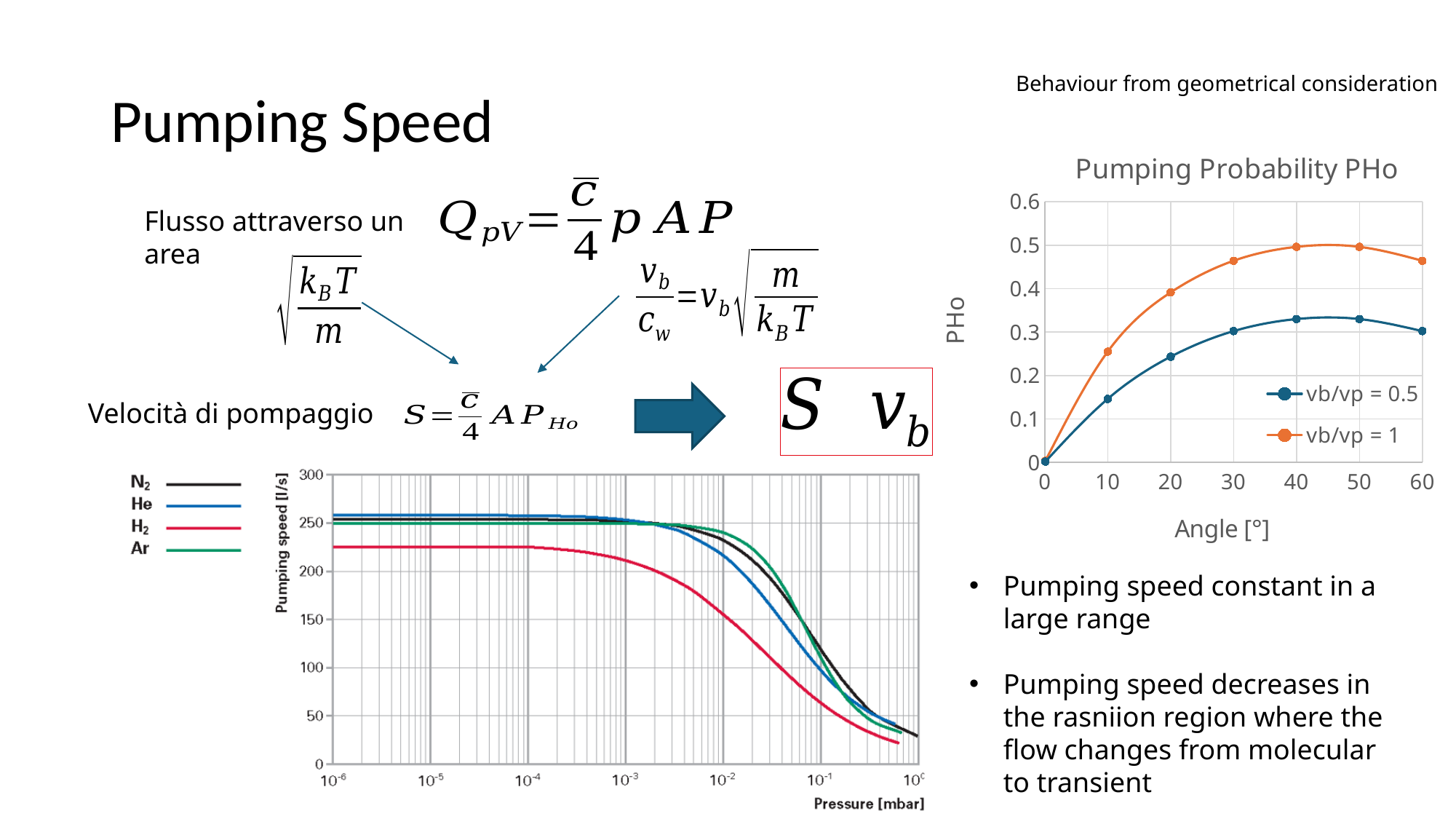
In the Pumping Probability PHo chart, which series has the higher value at 30°, vb/vp = 0.5 or vb/vp = 1? vb/vp = 1 In the bottom-left pumping speed vs pressure chart, how many gases does the legend list? 4 In the Pumping Probability PHo chart, is the value for vb/vp = 1 at 20° greater or less than 0.3? greater What kind of chart is the Pumping Probability PHo chart? line chart In the bottom-left pumping speed vs pressure chart, is the pumping speed for H2 at 10^-1 mbar greater or less than 100 l/s? less In the bottom-left pumping speed vs pressure chart, which gas has the larger pumping speed at 10^-2 mbar, H2 or Ar? Ar In the Pumping Probability PHo chart, how many series does the legend list? 2 What is the x-axis label of the Pumping Probability PHo chart? Angle [°] In the Pumping Probability PHo chart, is the value for vb/vp = 0.5 at 10° greater or less than 0.1? greater In the Pumping Probability PHo chart, how many data points are plotted for the vb/vp = 1 series? 7 In the Pumping Probability PHo chart, does the vb/vp = 1 series rise or fall between 0° and 30°? rise In the bottom-left pumping speed vs pressure chart, which gas has the lowest pumping speed at 10^-6 mbar? H2